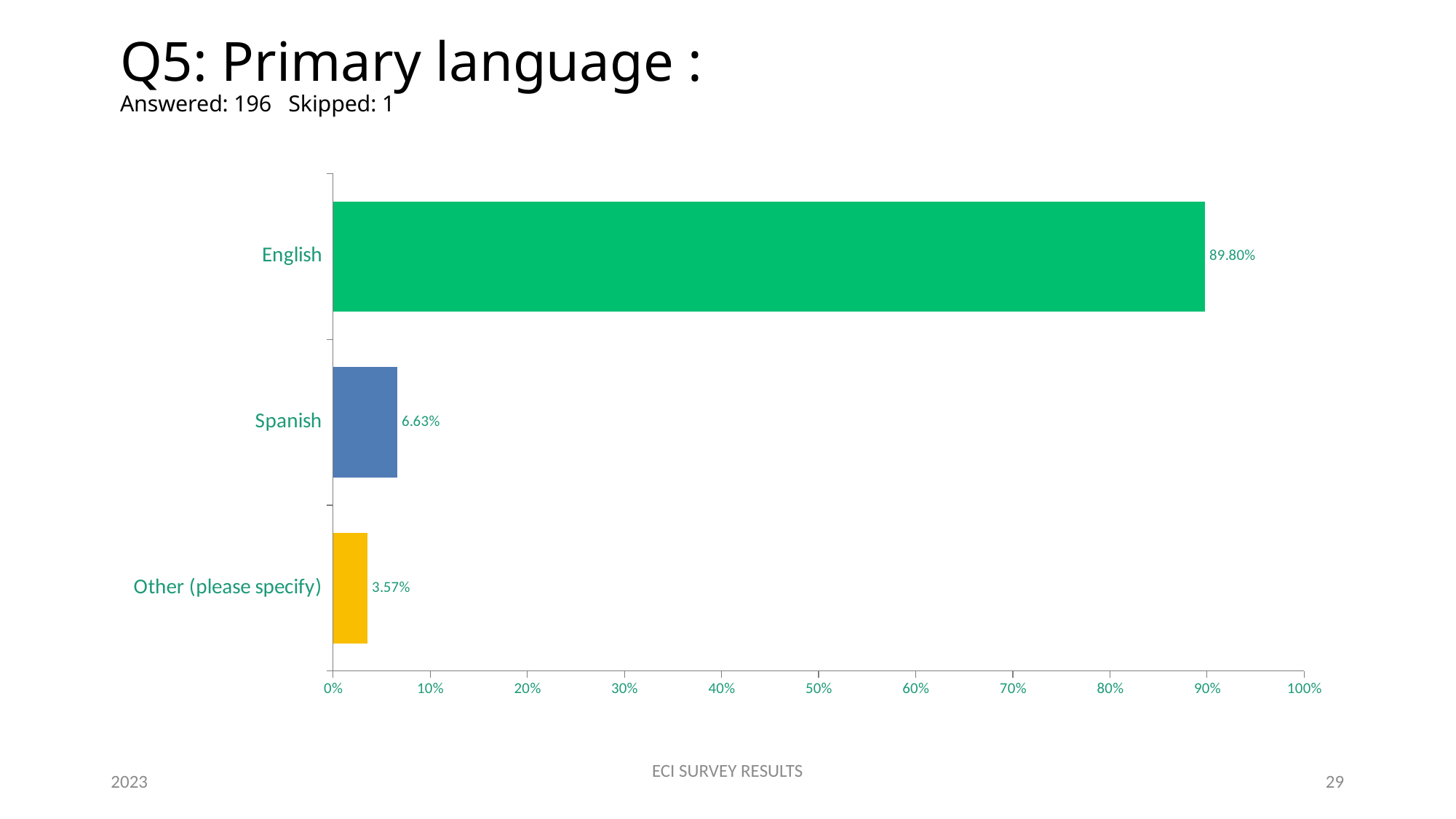
What kind of chart is shown on the slide? Bar chart Is the value for English greater or less than 80%? greater What percentage of respondents selected English as their primary language? 89.80% How many categories are shown in the chart? 3 What is the difference between the values for English and Spanish? 83.17% What is the value shown for Other (please specify)? 3.57% How many respondents answered this question according to the slide? 196 What is the difference between the values for Spanish and Other (please specify)? 3.06% Which is larger, the value for Spanish or the value for Other (please specify)? Spanish What is the value shown for Spanish? 6.63% Which category has the lowest value? Other (please specify) Which primary language category has the highest value? English